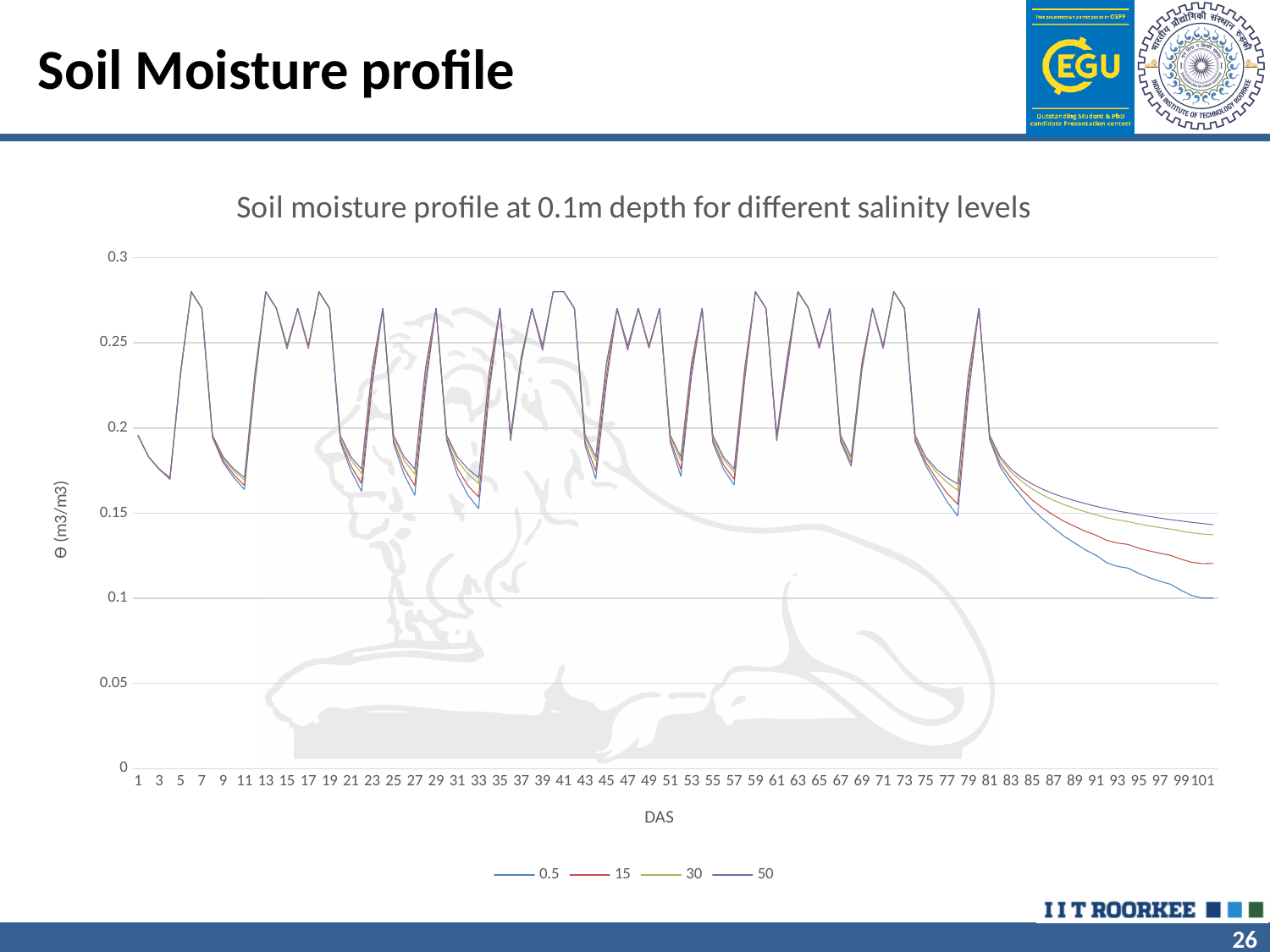
Is the value of the 50 series at DAS 101 greater or less than 0.1? greater How many series does the legend list? 4 Which series has the highest value at DAS 101? 50 What kind of chart is shown on the slide? line chart Which series has the lowest value at DAS 101? 0.5 At DAS 101, which series has the larger value, 15 or 30? 30 What is the label of the x axis? DAS At DAS 101, which series has the larger value, 50 or 0.5? 50 Is the value of the 15 series at DAS 101 greater or less than 0.15? less Is the highest peak reached by the series greater or less than 0.25? greater What is the title of the chart? Soil moisture profile at 0.1m depth for different salinity levels From DAS 81 to DAS 101, do the values of the series rise or fall? fall